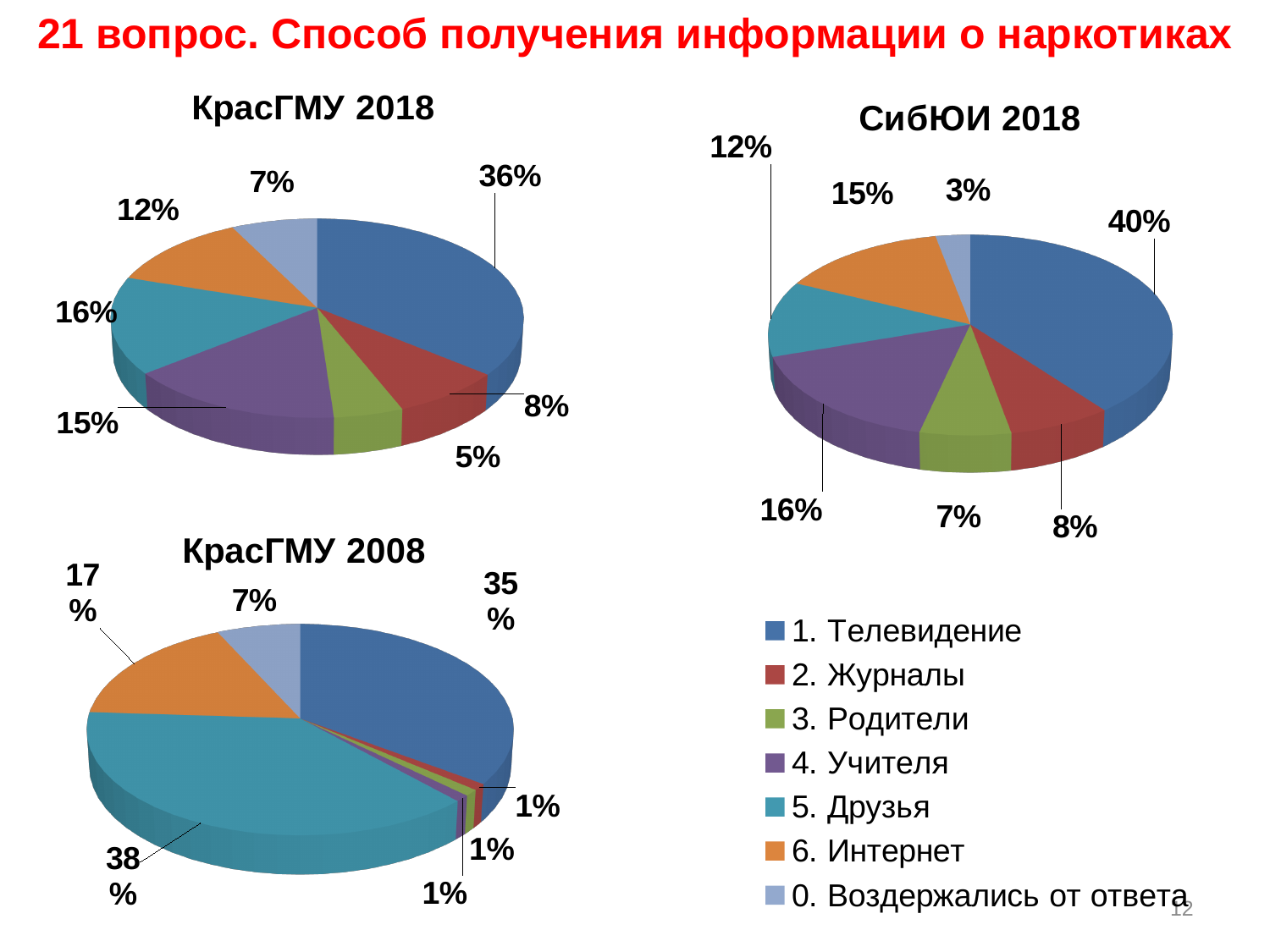
In the КрасГМУ 2008 chart, what share is shown for 5. Друзья? 38% In the СибЮИ 2018 chart, what share is shown for 0. Воздержались от ответа? 3% In the КрасГМУ 2018 chart, which is larger: the share for 5. Друзья or the share for 6. Интернет? 5. Друзья What kind of chart is the СибЮИ 2018 chart? Pie chart In the КрасГМУ 2018 chart, what share is shown for 1. Телевидение? 36% In the КрасГМУ 2008 chart, what share is shown for 6. Интернет? 17% How many categories does the legend list? 7 In the КрасГМУ 2008 chart, which category has the largest share? 5. Друзья In the СибЮИ 2018 chart, what share is shown for 4. Учителя? 16% In the СибЮИ 2018 chart, what is the difference between the shares for 1. Телевидение and 6. Интернет? 25% In the КрасГМУ 2018 chart, which category has the smallest share? 3. Родители In the СибЮИ 2018 chart, which category has the largest share? 1. Телевидение